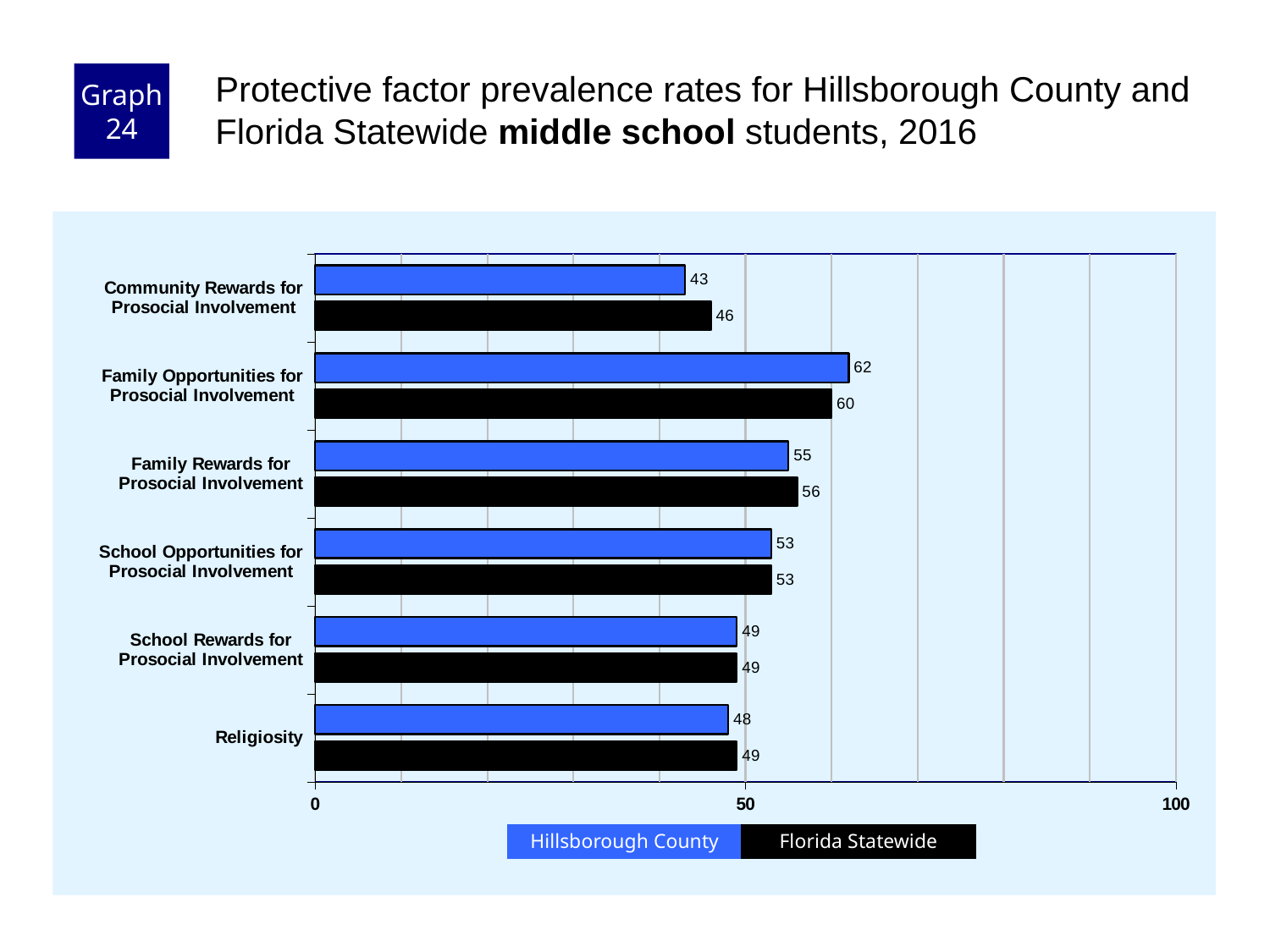
Is the Hillsborough County value for Family Rewards for Prosocial Involvement greater or less than 50? greater What is the difference between the Hillsborough County and Florida Statewide values for Community Rewards for Prosocial Involvement? 3 Which category has the highest Hillsborough County value? Family Opportunities for Prosocial Involvement How many categories are shown on the chart? 6 What is the Hillsborough County value for Community Rewards for Prosocial Involvement? 43 What is the Florida Statewide value for Family Opportunities for Prosocial Involvement? 60 Which colour represents Florida Statewide in the chart? black Which category has the lowest Florida Statewide value? Community Rewards for Prosocial Involvement What kind of chart is shown on the slide? bar chart Which is larger for Family Opportunities for Prosocial Involvement: the Hillsborough County value or the Florida Statewide value? Hillsborough County How many series does the legend list? 2 What is the Florida Statewide value for Religiosity? 49